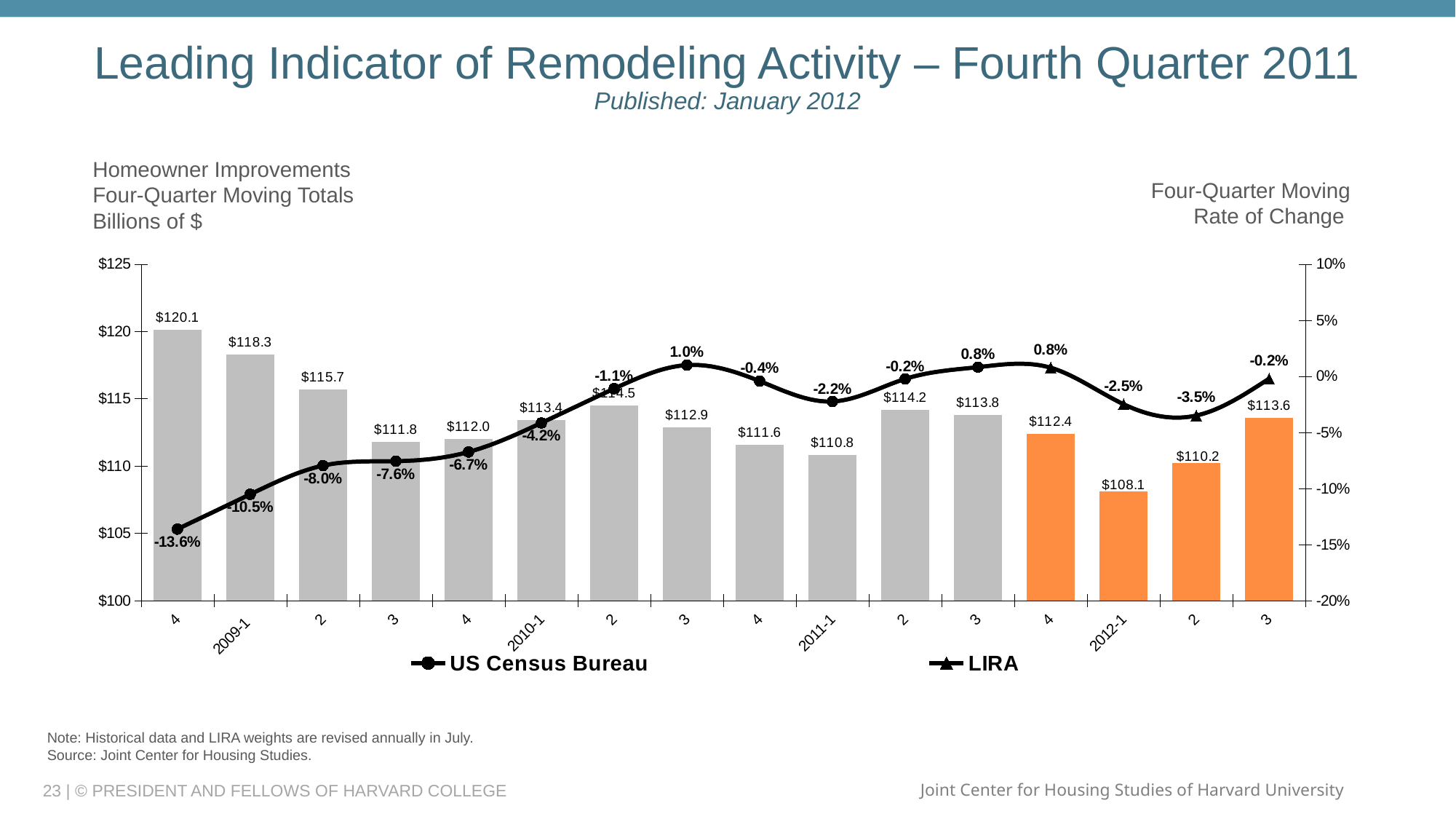
Which is larger, the four-quarter moving total for 2010-1 or for 2011-1? 2010-1 How many series does the legend list? 2 What kind of chart is this? Combination bar and line chart Which period has the highest four-quarter moving total bar? 4 (the first bar, before 2009-1), $120.1 What is the four-quarter moving rate of change shown for 2010-1? -4.2% What is the difference between the four-quarter moving totals for 2009-1 and 2012-1? $10.2 What are the two series named in the legend? US Census Bureau and LIRA Which period has the lowest four-quarter moving total bar? 2012-1, $108.1 How many bars are plotted in the chart? 16 What is the four-quarter moving rate of change shown for 2011-1? -2.2% What is the four-quarter moving total for 2012-1? $108.1 What is the four-quarter moving total for 2009-1? $118.3